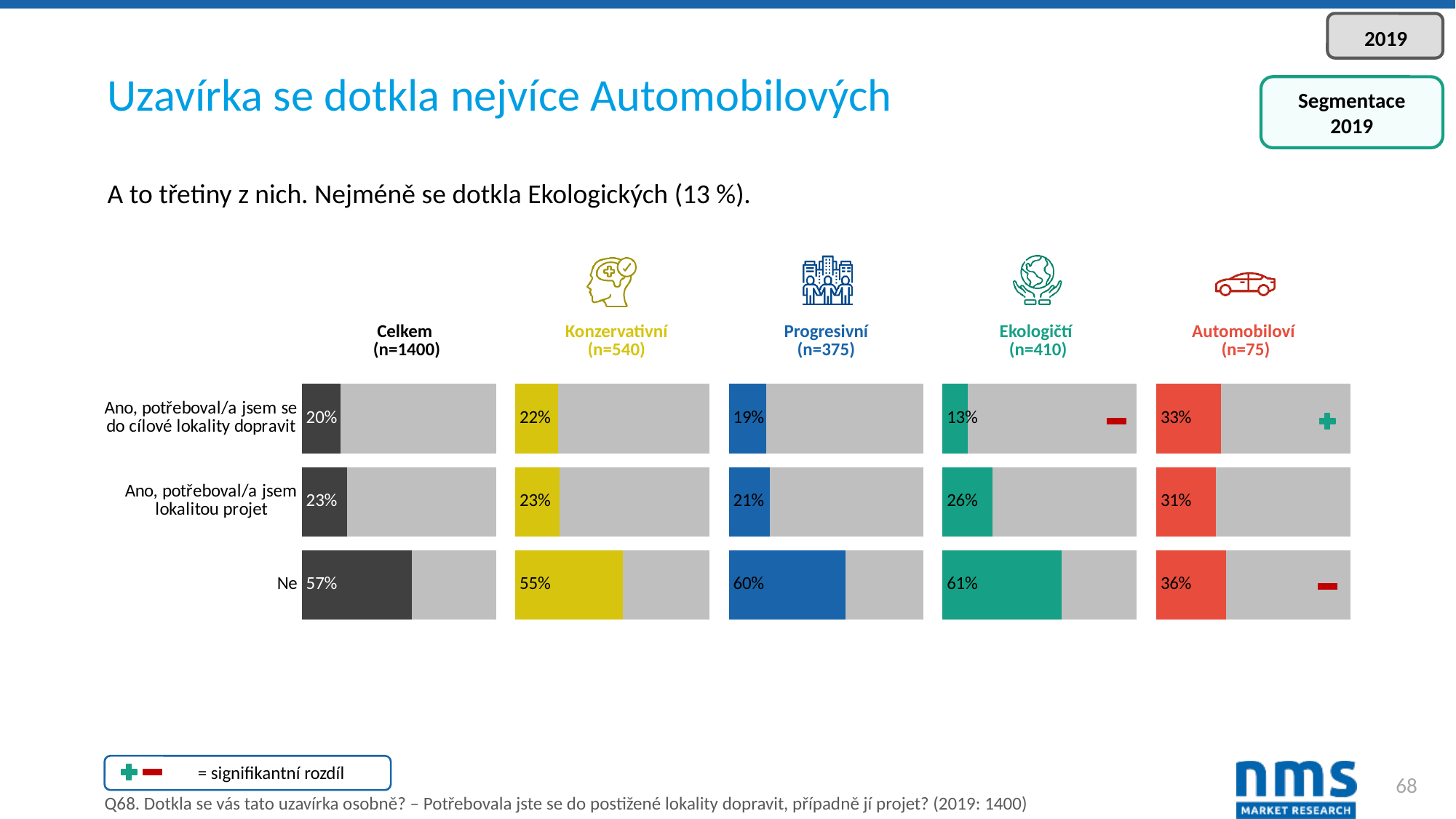
Which is larger: the "Ne" value in the Konzervativní (n=540) chart or the "Ne" value in the Progresivní (n=375) chart? Progresivní (n=375) In the Progresivní (n=375) chart, which category has the highest value? Ne In the Ekologičtí (n=410) chart, which category has the lowest value? Ano, potřeboval/a jsem se do cílové lokality dopravit What kind of chart is used to show the values on this slide? Bar chart In the Celkem (n=1400) chart, what is the value for "Ne"? 57% Across the five segment charts, which segment has the lowest value for "Ano, potřeboval/a jsem se do cílové lokality dopravit"? Ekologičtí What is the difference between the "Ne" value in the Ekologičtí (n=410) chart and the "Ne" value in the Automobiloví (n=75) chart? 25% How many segment charts are shown on the slide? 5 In the Automobiloví (n=75) chart, what is the value for "Ano, potřeboval/a jsem se do cílové lokality dopravit"? 33% What do the green plus and red minus symbols next to the bars indicate, according to the legend? Signifikantní rozdíl How many categories (rows) does each segment chart show? 3 In the Ekologičtí (n=410) chart, what is the value for "Ano, potřeboval/a jsem lokalitou projet"? 26%